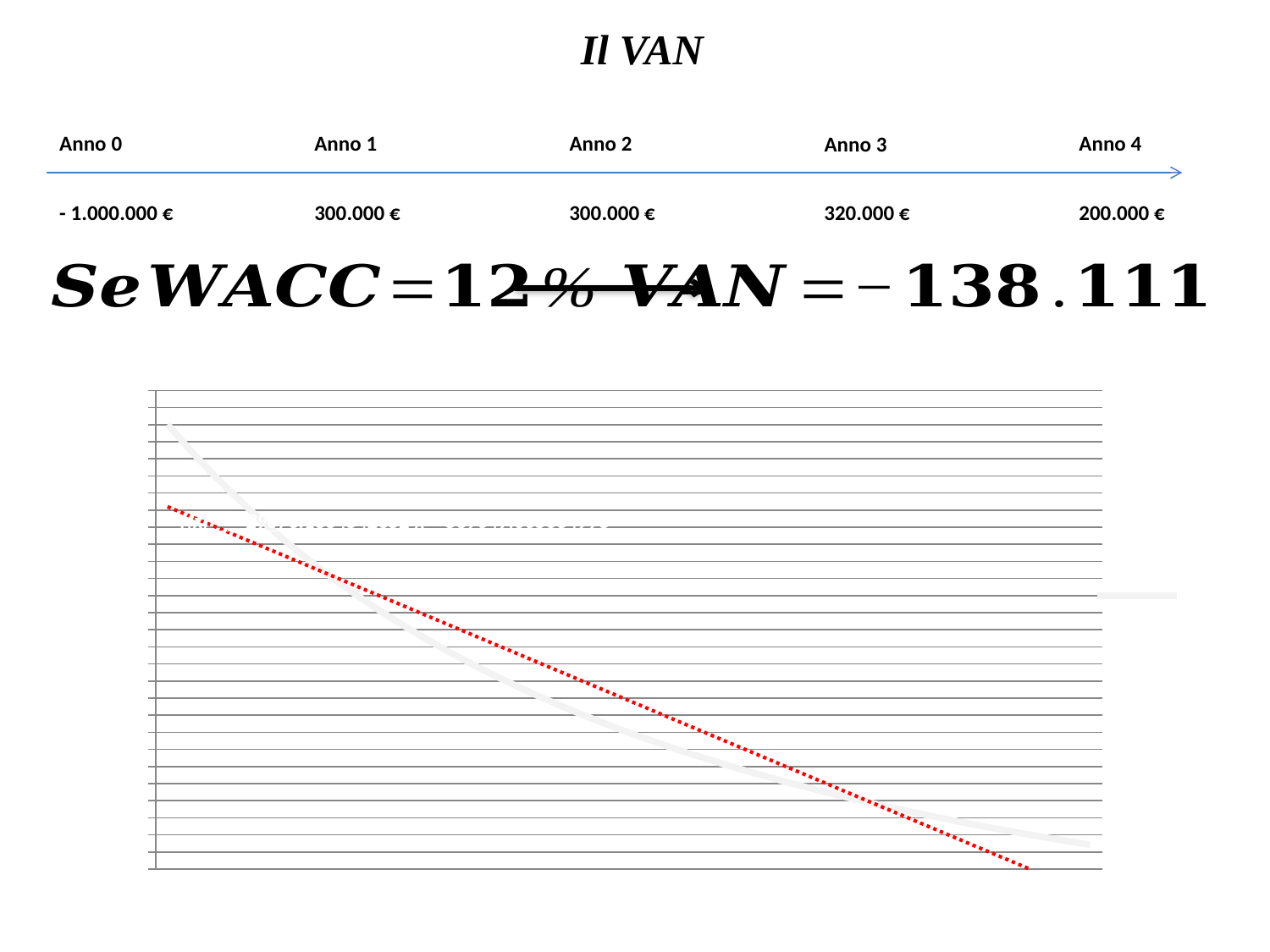
How many lines are plotted on the chart? 2 What colour is the dotted line plotted on the chart? red What kind of chart is shown on the slide? line chart Do the plotted lines rise or fall from left to right along the x axis? fall